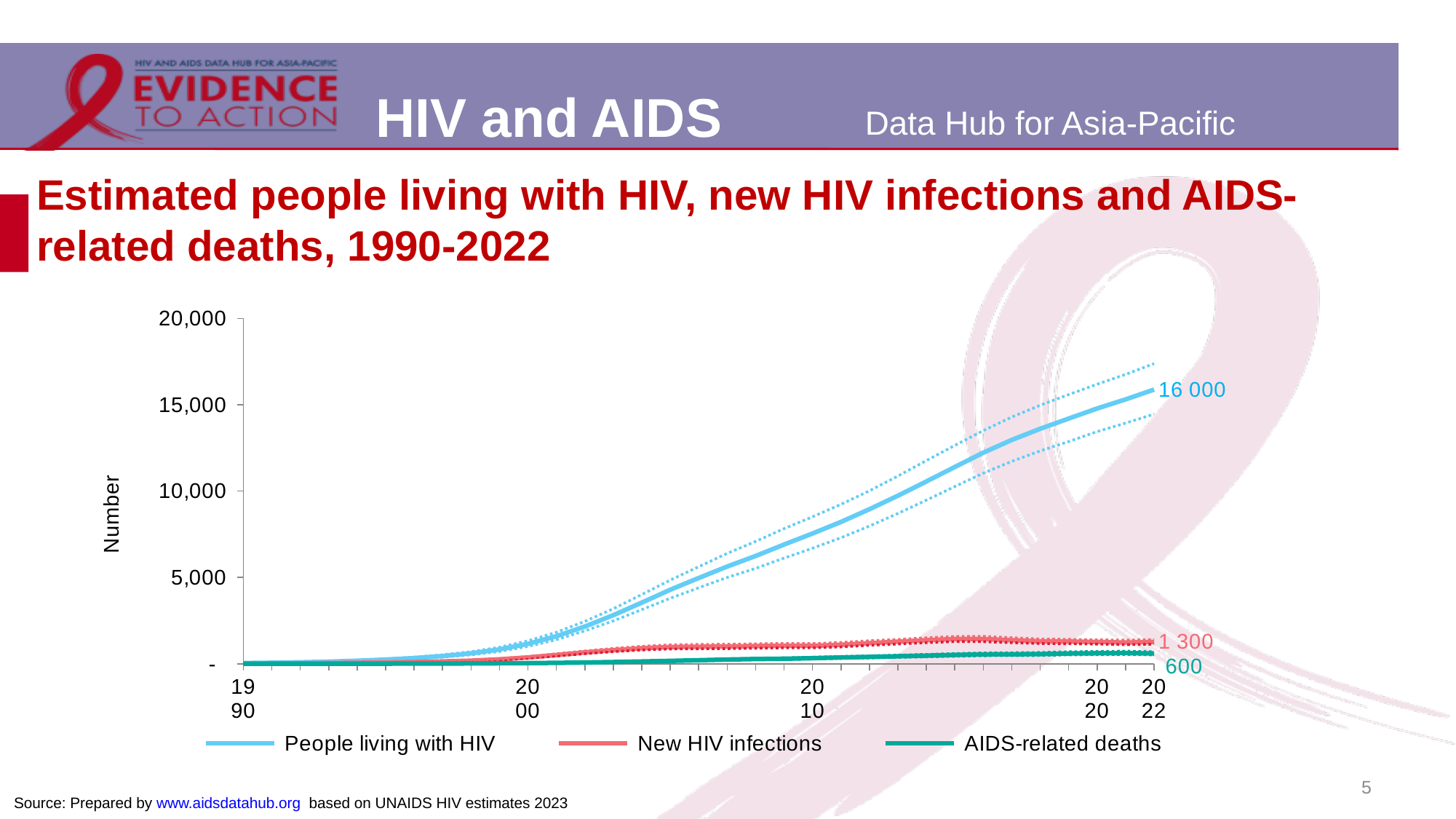
Is the value for People living with HIV in 2010 greater or less than 10,000? less What is the difference between New HIV infections and AIDS-related deaths in 2022? 700 What kind of chart is shown on the slide? Line chart Is the value for People living with HIV in 2020 greater or less than 10,000? greater What is the value for People living with HIV in 2022? 16 000 Which is larger in 2022, New HIV infections or AIDS-related deaths? New HIV infections Does the People living with HIV line rise or fall from 1990 to 2022? Rise Which series has the lowest value in 2022? AIDS-related deaths How many series does the legend list? 3 Which series has the highest value in 2022? People living with HIV What is the value for New HIV infections in 2022? 1 300 What is the value for AIDS-related deaths in 2022? 600